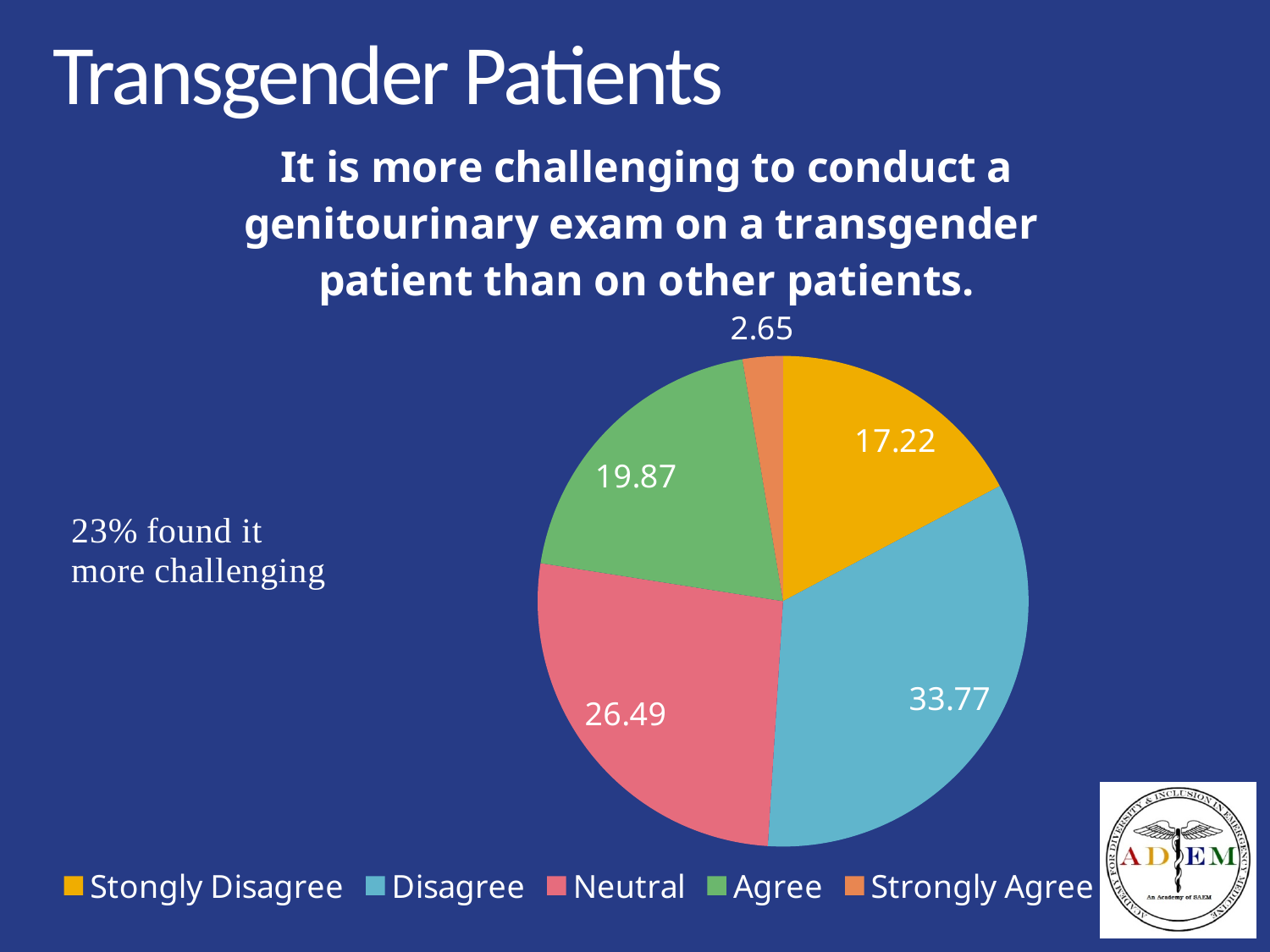
Which response category has the largest slice in the pie chart? Disagree Which is larger in the pie chart, the Agree slice or the Stongly Disagree slice? Agree How many response categories does the pie chart show? 5 What colour is the Neutral slice in the pie chart? Pink What type of chart is shown on the slide? Pie chart What is the value of the Strongly Agree slice in the pie chart? 2.65 Which response category has the smallest slice in the pie chart? Strongly Agree What is the difference between the Disagree and Neutral values in the pie chart? 7.28 What is the value of the Disagree slice in the pie chart? 33.77 What is the value of the Stongly Disagree slice in the pie chart? 17.22 What is the value of the Agree slice in the pie chart? 19.87 What is the value of the Neutral slice in the pie chart? 26.49